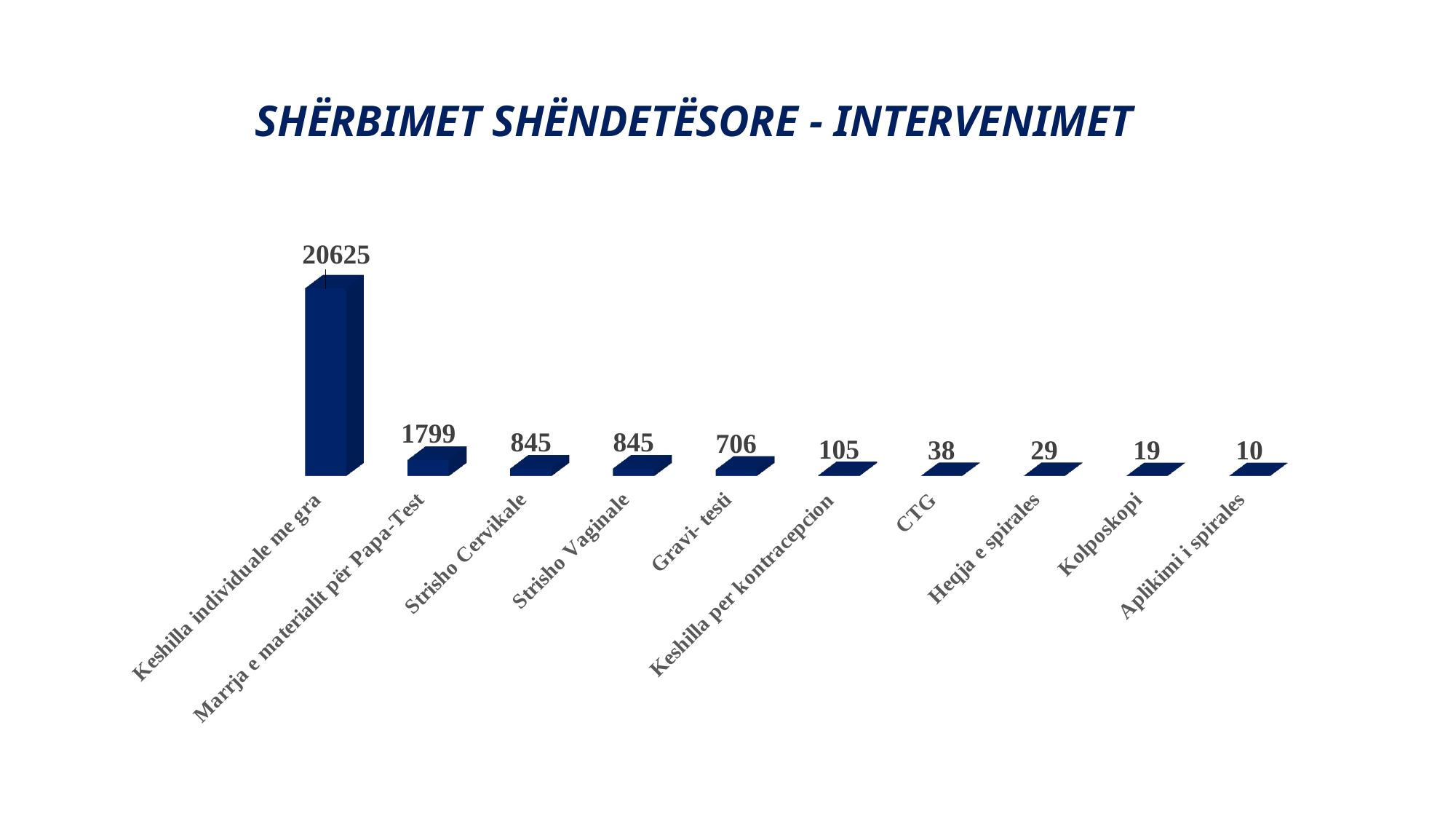
How many categories are shown in the chart? 10 What is the value for Marrja e materialit për Papa-Test? 1799 What kind of chart is shown on the slide? Bar chart What is the value for Keshilla individuale me gra? 20625 Which is larger, the value for Gravi- testi or the value for Heqja e spirales? Gravi- testi What is the value for CTG? 38 What is the difference between the values for Keshilla per kontracepcion and CTG? 67 What is the value for Kolposkopi? 19 What is the value for Gravi- testi? 706 What is the difference between the values for Marrja e materialit për Papa-Test and Strisho Cervikale? 954 Which category has the highest value? Keshilla individuale me gra Which category has the lowest value? Aplikimi i spirales